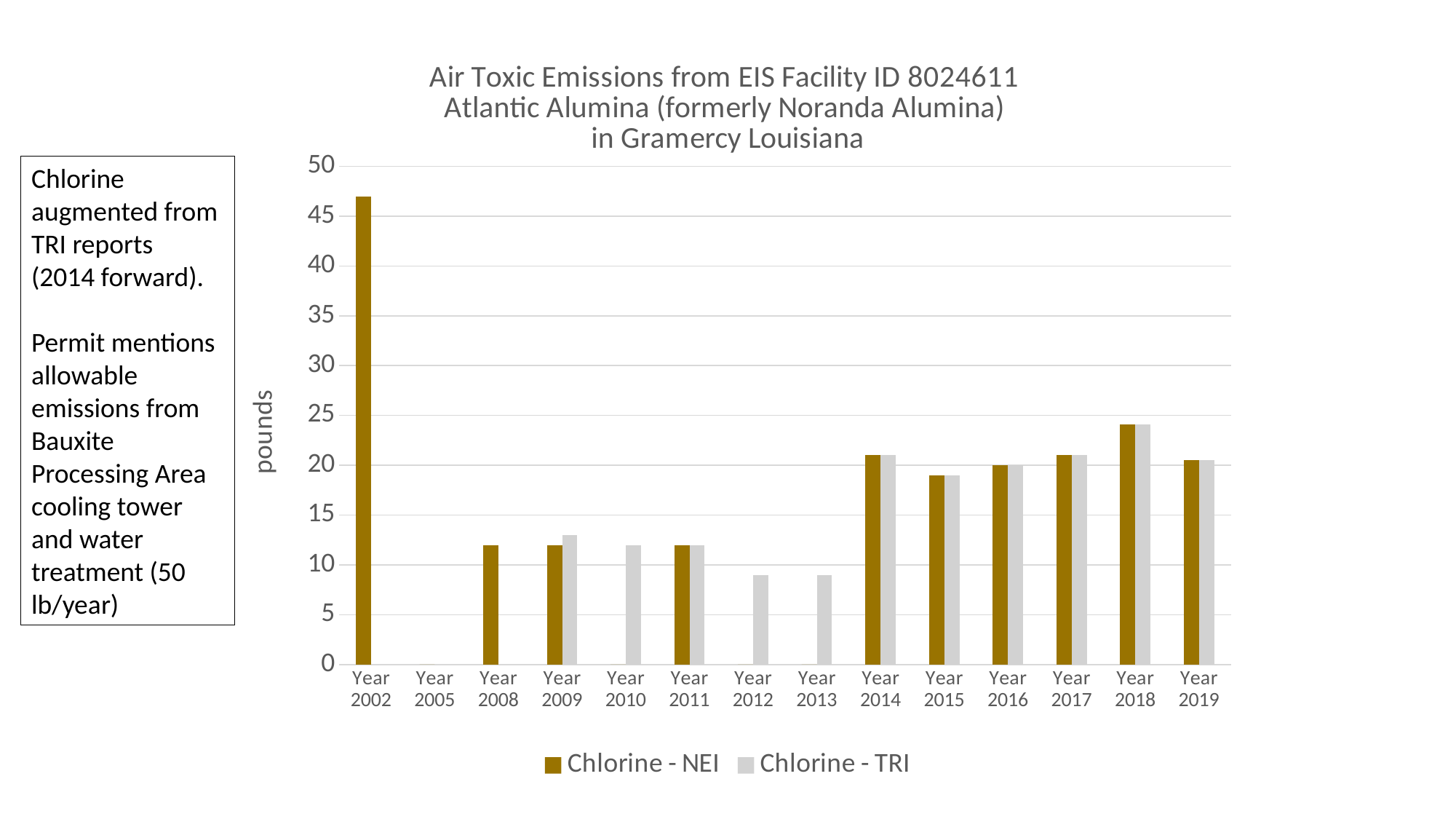
Which is larger, the Chlorine - NEI value for Year 2018 or for Year 2015? Year 2018 Which year has the highest Chlorine - NEI value? Year 2002 How many series does the legend list? 2 What kind of chart is shown on the slide? bar chart Which is larger for Year 2009, the Chlorine - NEI bar or the Chlorine - TRI bar? Chlorine - TRI Is the Chlorine - NEI value for Year 2018 greater or less than 25? less Which year on the x axis has no bars plotted? Year 2005 What is the label on the y axis? pounds What is the Chlorine - NEI value for Year 2016? 20 How many year categories are shown on the x axis? 14 Is the Chlorine - TRI value for Year 2012 greater or less than 10? less Is the Chlorine - NEI value for Year 2002 greater or less than 45? greater